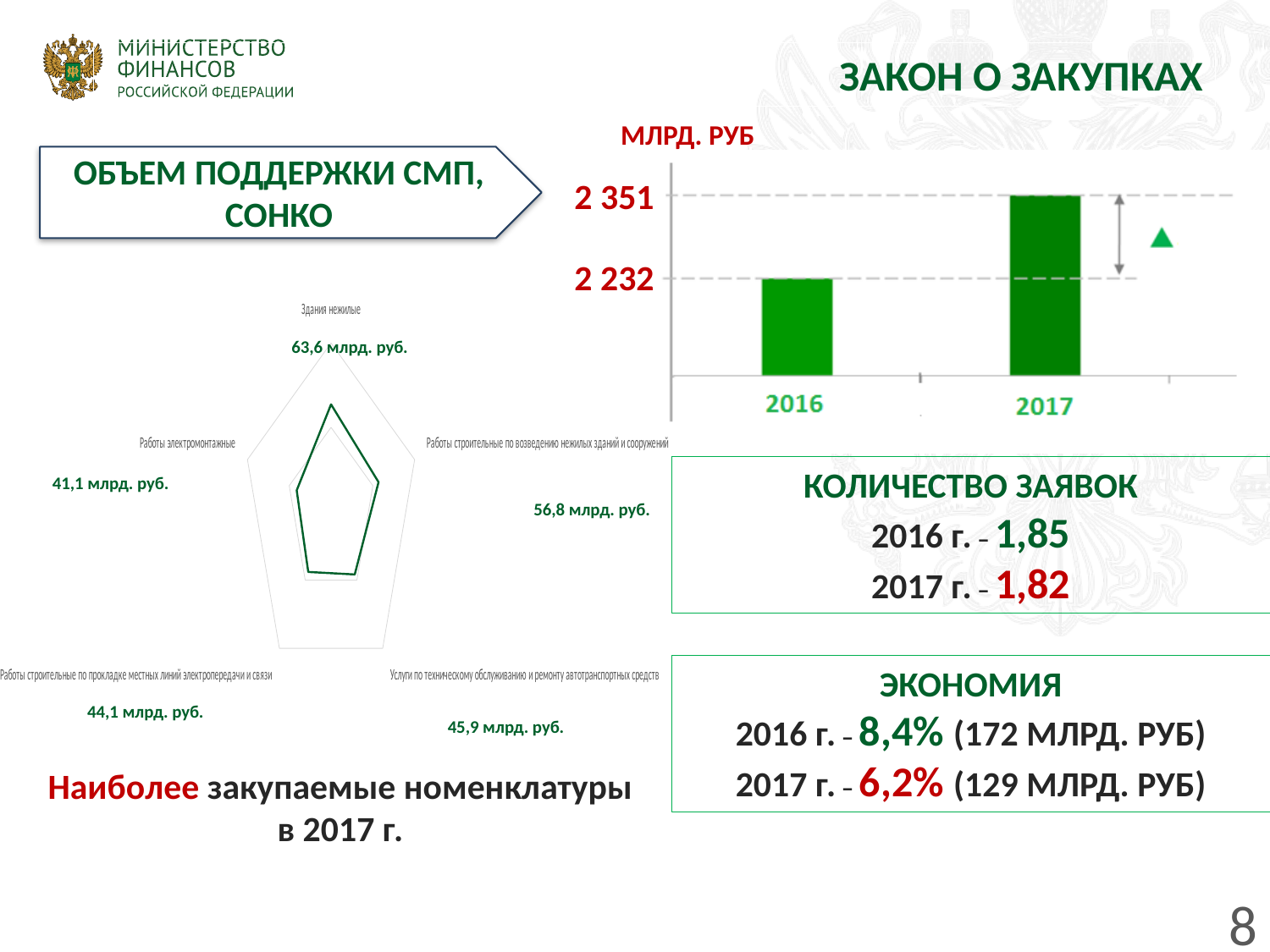
In the bar chart at the top right, how many bars are plotted? 2 In the radar chart on the left, which category has the lowest value? Работы электромонтажные In the bar chart at the top right, what is the value for 2016? 2 232 In the bar chart at the top right, what unit is stated above the axis? МЛРД. РУБ In the radar chart on the left, what is the difference between the values for Здания нежилые and Работы электромонтажные? 22,5 млрд. руб. What type of chart is shown at the top right of the slide? bar chart In the radar chart on the left, what is the value for Здания нежилые? 63,6 млрд. руб. In the bar chart at the top right, which year has the higher value, 2016 or 2017? 2017 In the bar chart at the top right, by how much does the 2017 value exceed the 2016 value? 119 In the bar chart at the top right, do the values rise or fall from 2016 to 2017? rise In the radar chart on the left, how many categories are plotted? 5 In the bar chart at the top right, what is the value for 2017? 2 351